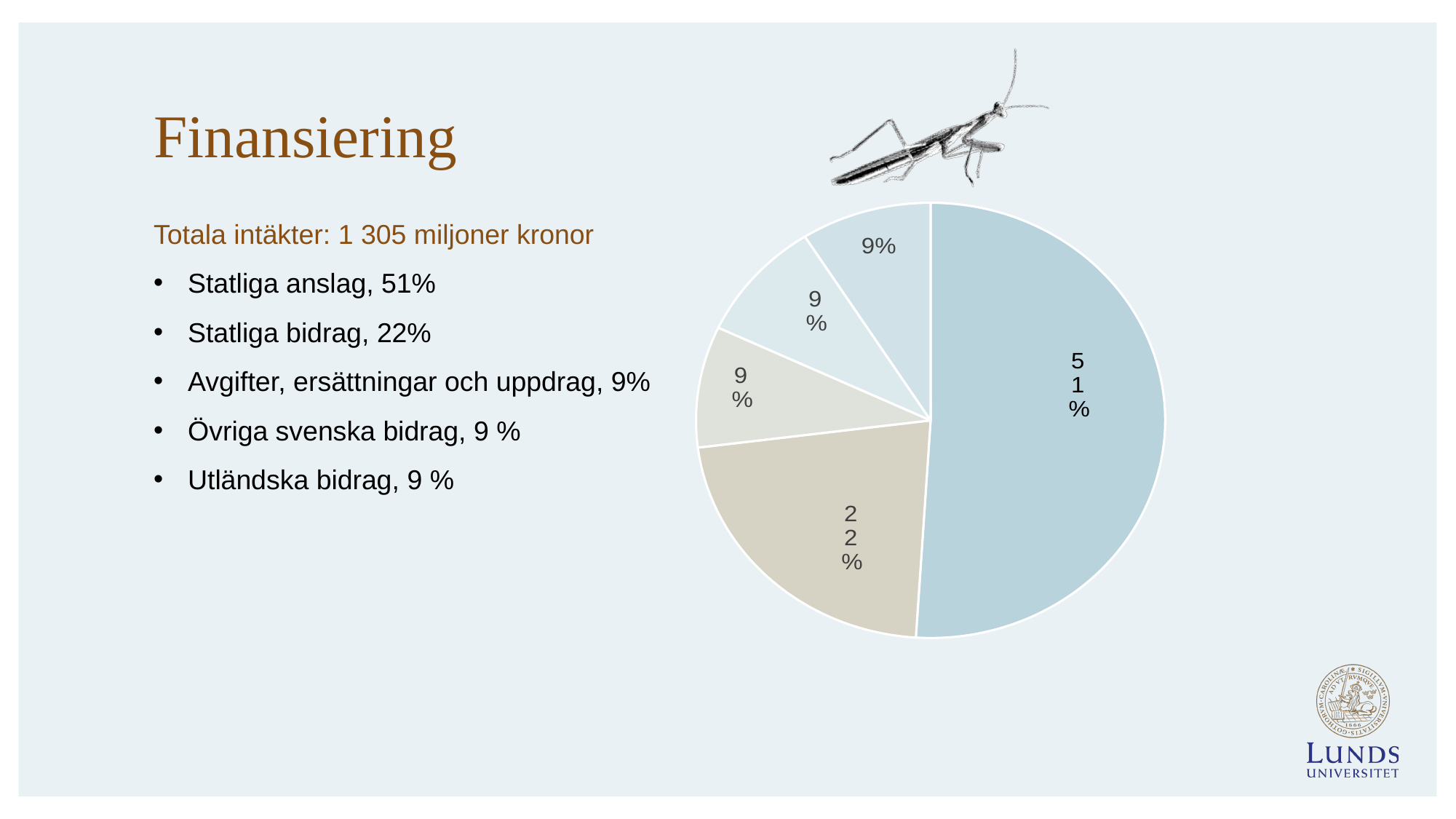
What is the title of the slide containing the pie chart? Finansiering What is the value of the smallest slices in the pie chart? 9% How many slices in the pie chart are labelled 9%? 3 What is the difference between the largest slice (51%) and the second largest slice (22%) in the pie chart? 29 percentage points Does the pie chart have a legend? No What share of the pie does Statliga bidrag represent? 22% What share of the pie does Statliga anslag represent? 51% What is the value of the largest slice in the pie chart? 51% What is the combined share of the three 9% slices in the pie chart? 27% How many slices does the pie chart have? 5 Which is larger in the pie chart, the 22% slice or a 9% slice? the 22% slice What kind of chart is shown on the slide? pie chart